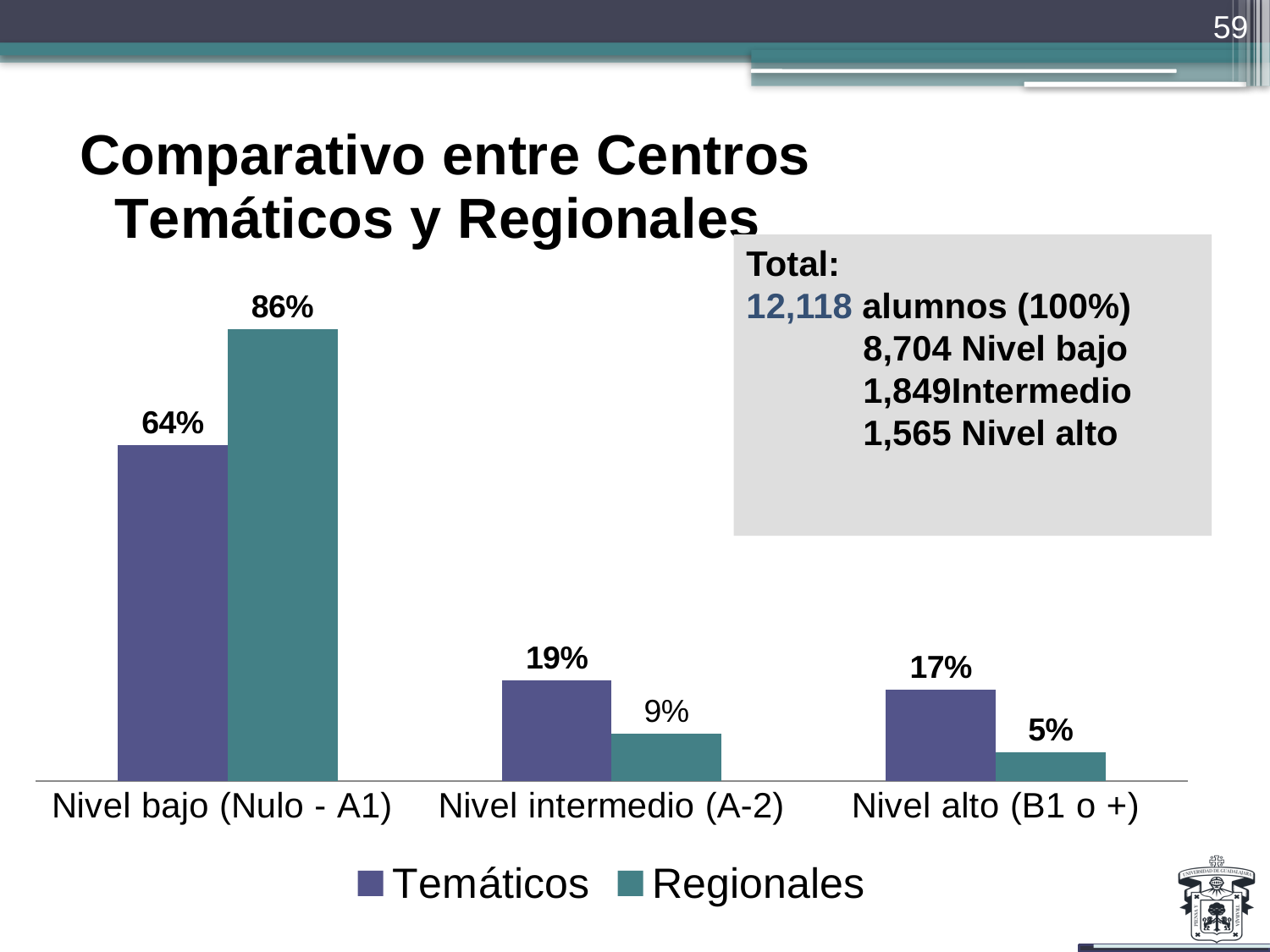
What is the difference between the Regionales and Temáticos values in the Nivel bajo (Nulo - A1) category? 22% What kind of chart is shown on the slide? Bar chart What is the value for Temáticos in the Nivel intermedio (A-2) category? 19% How many categories are shown on the x axis? 3 In the Nivel alto (B1 o +) category, which series has the larger value, Temáticos or Regionales? Temáticos How many series does the legend list? 2 What is the value for Regionales in the Nivel alto (B1 o +) category? 5% What is the value for Temáticos in the Nivel bajo (Nulo - A1) category? 64% What is the difference between the Temáticos and Regionales values in the Nivel intermedio (A-2) category? 10% Which category has the highest value for Regionales? Nivel bajo (Nulo - A1) Which category has the lowest value for Temáticos? Nivel alto (B1 o +) What is the value for Regionales in the Nivel bajo (Nulo - A1) category? 86%